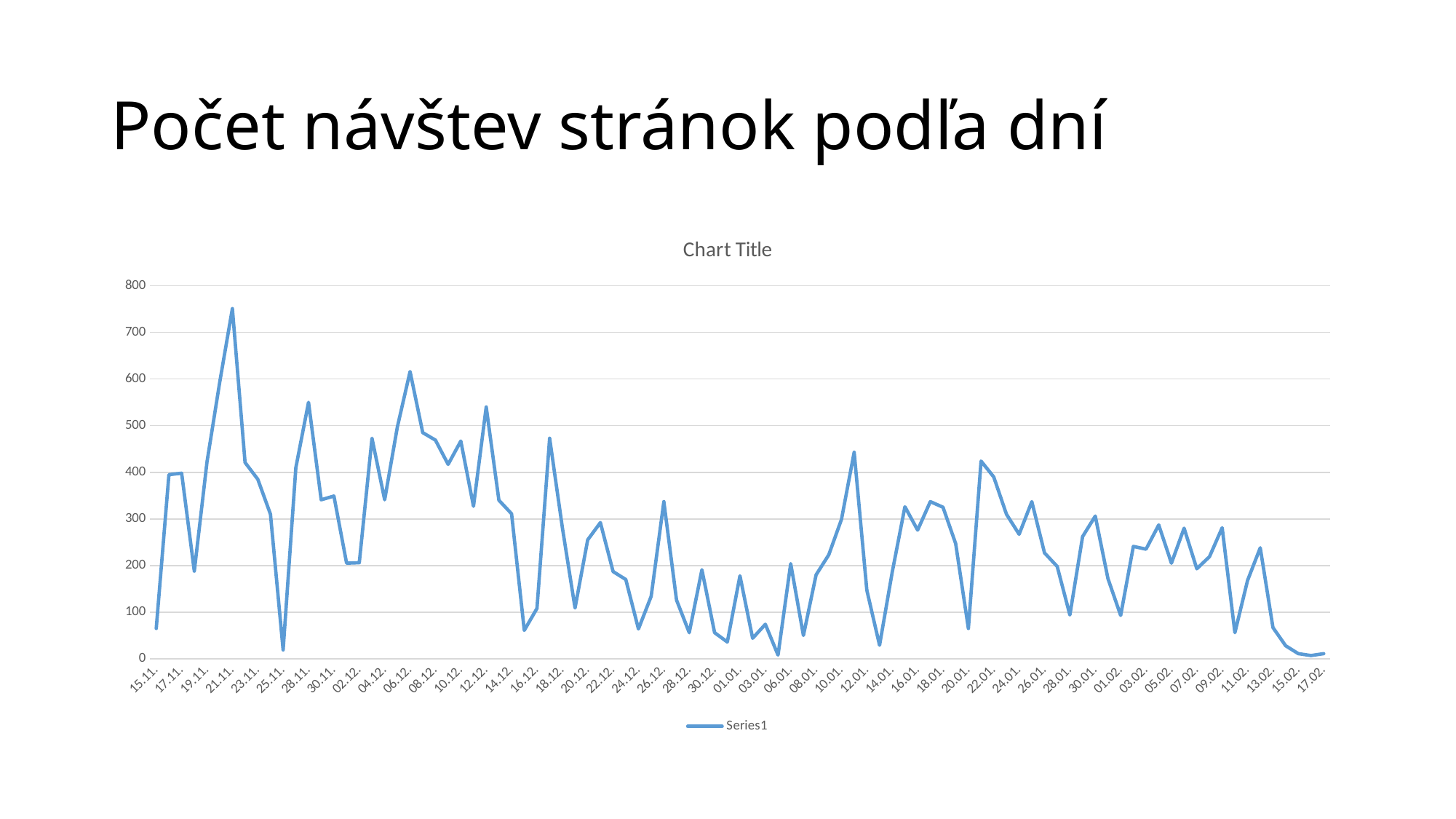
Is the value for 15.11. greater or less than 100? less Is the highest value on the chart greater or less than 800? less How many series does the legend list? 1 What title is printed above the chart? Chart Title Is the highest value on the chart greater or less than 700? greater What is the highest value shown on the vertical axis? 800 Do the values generally rise or fall from left to right along the x axis? fall What is the name of the series shown in the legend? Series1 Is the value for 15.11. greater or less than the value for 17.02.? greater What kind of chart is shown on the slide? line chart